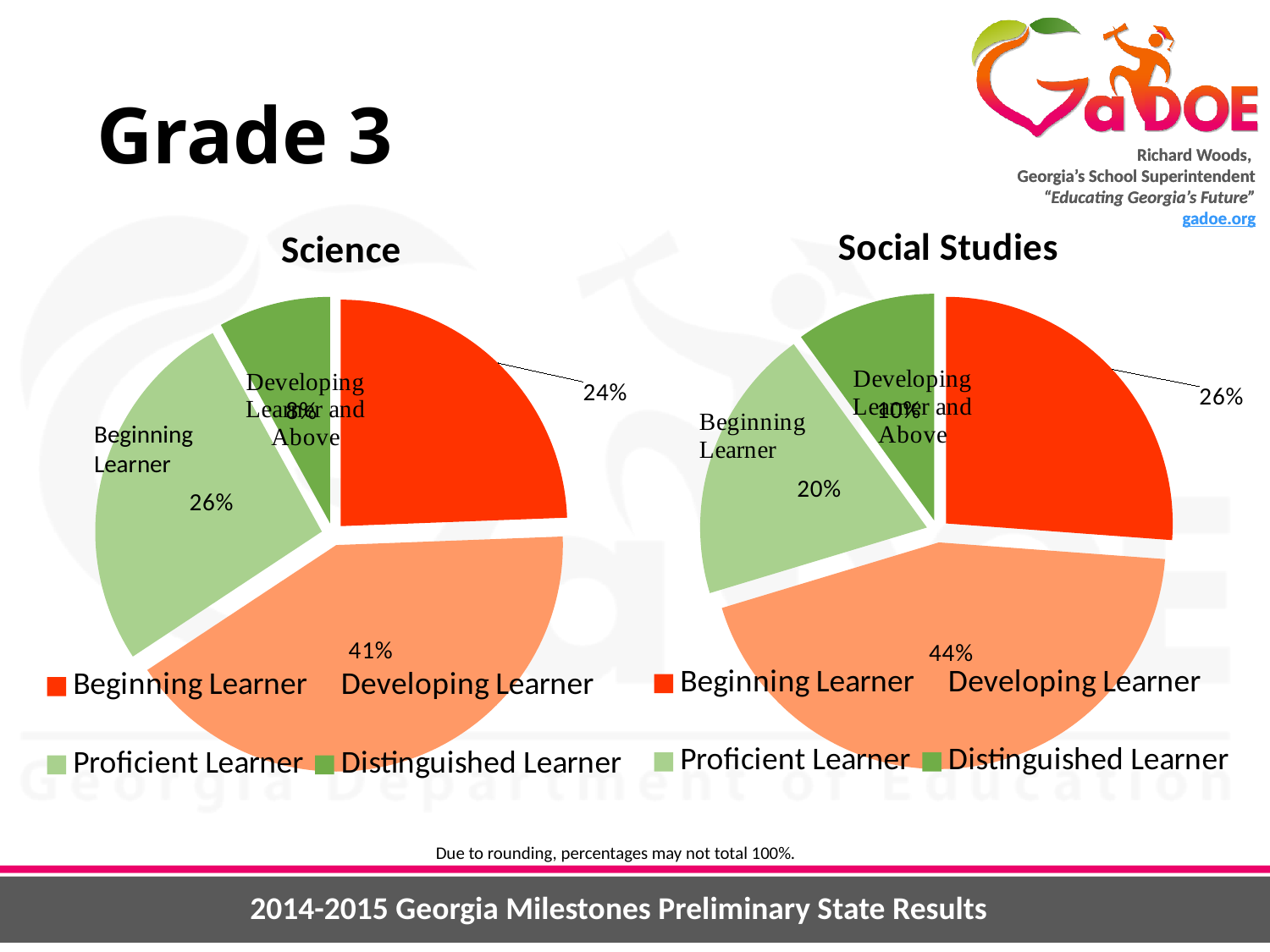
In the Social Studies chart, what is the difference between the Developing Learner and Beginning Learner percentages? 18% How many entries does the legend of the Social Studies chart list? 4 In the Science chart, which achievement level has the largest share? Developing Learner In the Social Studies chart, what percentage of students are Developing Learners? 44% In the Science chart, what percentage of students are Developing Learners? 41% In the Social Studies chart, what percentage of students are Beginning Learners? 26% In the Science chart, which is larger: the Proficient Learner share or the Beginning Learner share? Proficient Learner In the Science chart, what percentage of students are Proficient Learners? 26% In the Social Studies chart, what percentage of students are Proficient Learners? 20% What type of chart is used for the Science results? Pie chart In the Science chart, what percentage of students are Beginning Learners? 24% In the Social Studies chart, which achievement level has the smallest share? Distinguished Learner